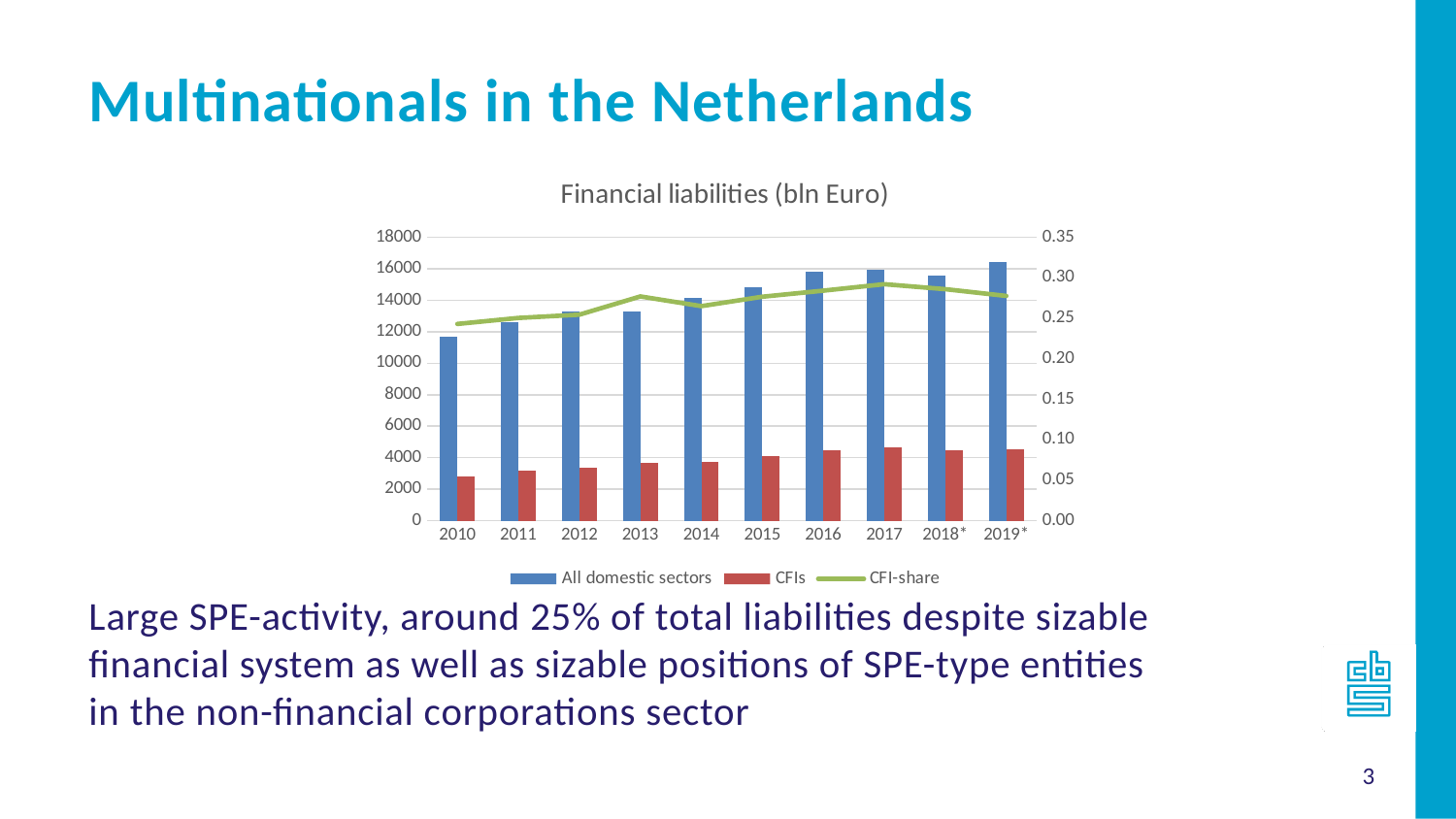
What kind of chart is used for the 'All domestic sectors' and 'CFIs' series? Bar chart What is the title of the chart? Financial liabilities (bln Euro) In which year is the value for 'All domestic sectors' lowest? 2010 Is the value for 'All domestic sectors' in 2019* greater or less than 16000? greater How many series does the chart legend list? 3 In which year is the value for 'CFIs' lowest? 2010 Which is larger, the 'All domestic sectors' value in 2016 or in 2015? 2016 Is the 'CFI-share' value in 2017 greater or less than 0.25? greater How many years are shown on the x axis of the chart? 10 Is the value for 'All domestic sectors' in 2010 greater or less than 12000? less In which year is the value for 'All domestic sectors' highest? 2019*